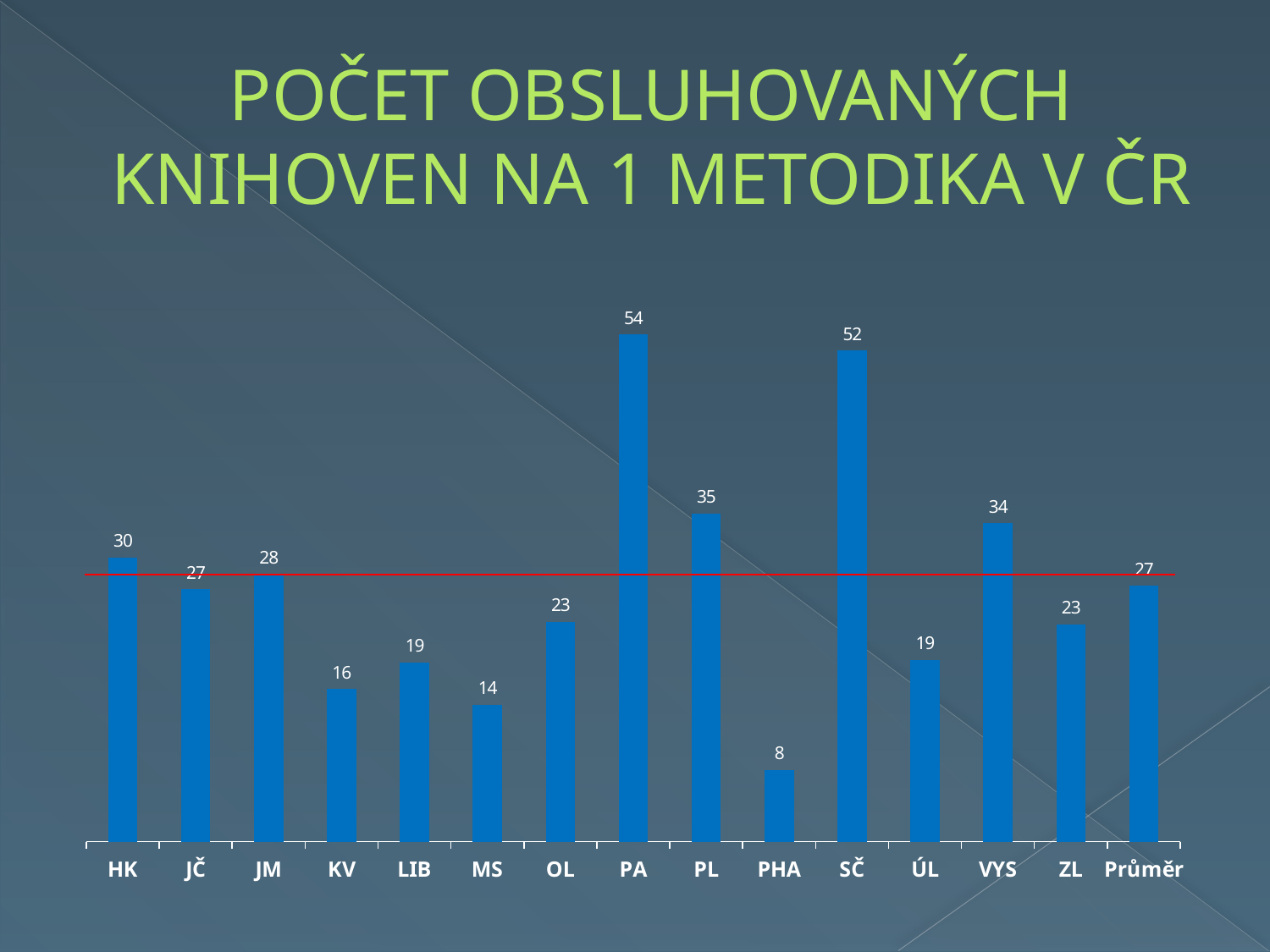
What is the value for PHA? 8 Which category has the lowest value? PHA What is the difference between the values for VYS and ÚL? 15 What is the difference between the values for PA and SČ? 2 Which is larger, the value for HK or the value for JM? HK What kind of chart is shown on the slide? bar chart Which category has the highest value? PA What is the value for PA? 54 How many categories are shown on the x axis? 15 What is the title of the slide? POČET OBSLUHOVANÝCH KNIHOVEN NA 1 METODIKA V ČR Which is larger, the value for PL or the value for OL? PL What is the value for Průměr? 27